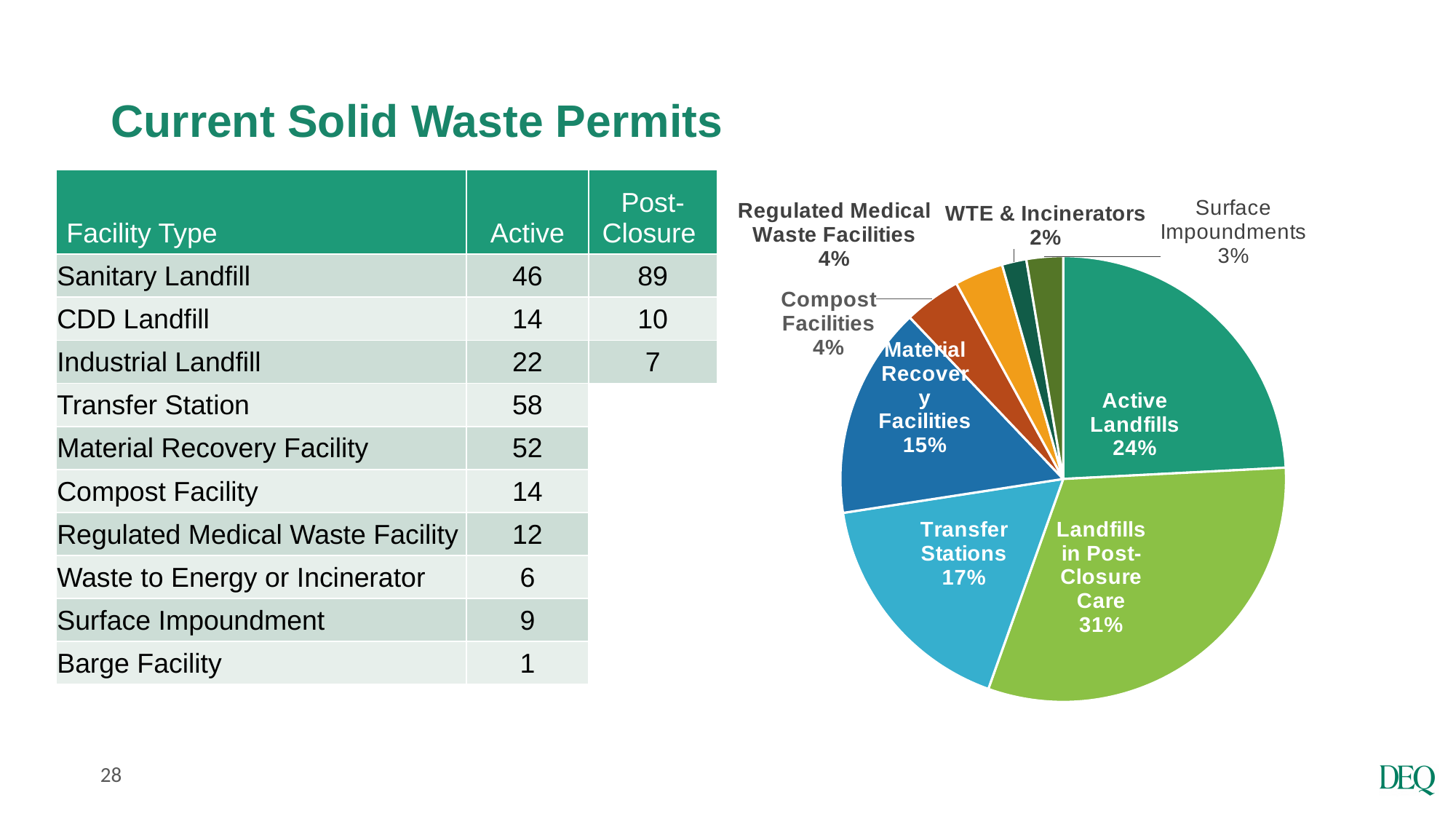
In the pie chart, what percentage is shown for WTE & Incinerators? 2% In the pie chart, what percentage is shown for Surface Impoundments? 3% In the pie chart, what share is labeled for Active Landfills? 24% What kind of chart is shown on the right side of the slide? pie chart In the pie chart, what share is labeled for Landfills in Post-Closure Care? 31% How many labeled slices does the pie chart have? 8 In the pie chart, what percentage is shown for Material Recovery Facilities? 15% In the pie chart, which is larger: Transfer Stations or Material Recovery Facilities? Transfer Stations In the pie chart, which slice has the largest share? Landfills in Post-Closure Care In the pie chart, which slice has the smallest labeled share? WTE & Incinerators In the pie chart, what is the difference in percentage points between Landfills in Post-Closure Care and Active Landfills? 7 In the pie chart, what percentage is shown for Transfer Stations? 17%